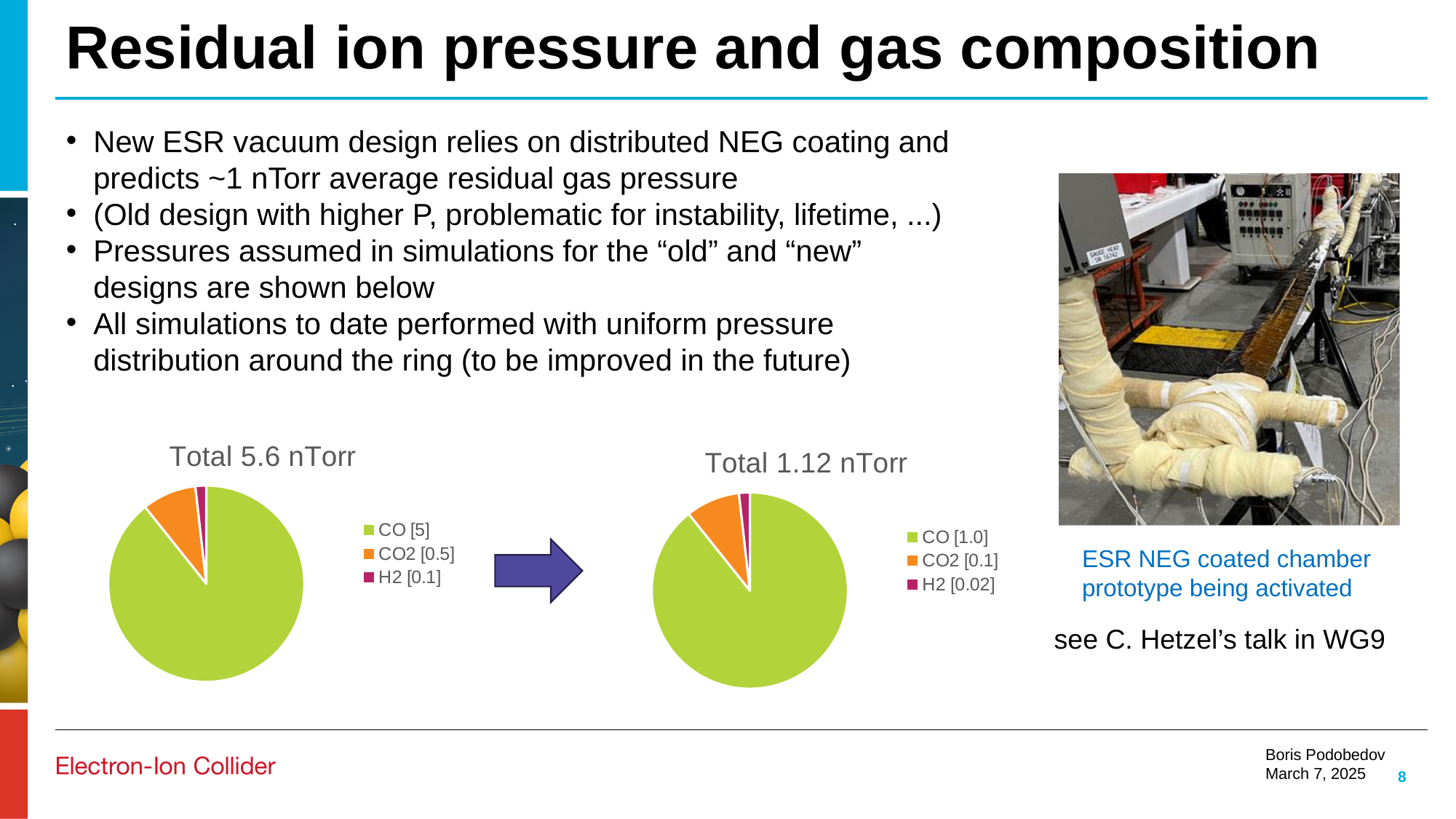
In the 'Total 5.6 nTorr' pie chart, what value is given for CO? 5 What colour represents CO in both pie charts? Green In the 'Total 5.6 nTorr' pie chart, which is larger, the CO2 value or the H2 value? CO2 In the 'Total 1.12 nTorr' pie chart, what value is given for H2? 0.02 In the 'Total 1.12 nTorr' pie chart, which gas has the smallest slice? H2 In the 'Total 5.6 nTorr' pie chart, what value is given for CO2? 0.5 What type of chart is used to show the gas composition on the left ('Total 5.6 nTorr')? Pie chart In the 'Total 5.6 nTorr' pie chart, what is the difference between the CO value and the CO2 value? 4.5 In the 'Total 5.6 nTorr' pie chart, which gas has the largest slice? CO In the 'Total 1.12 nTorr' pie chart, what value is given for CO? 1.0 How many gases are listed in the legend of the 'Total 1.12 nTorr' pie chart? 3 In the 'Total 1.12 nTorr' pie chart, what is the difference between the CO2 value and the H2 value? 0.08